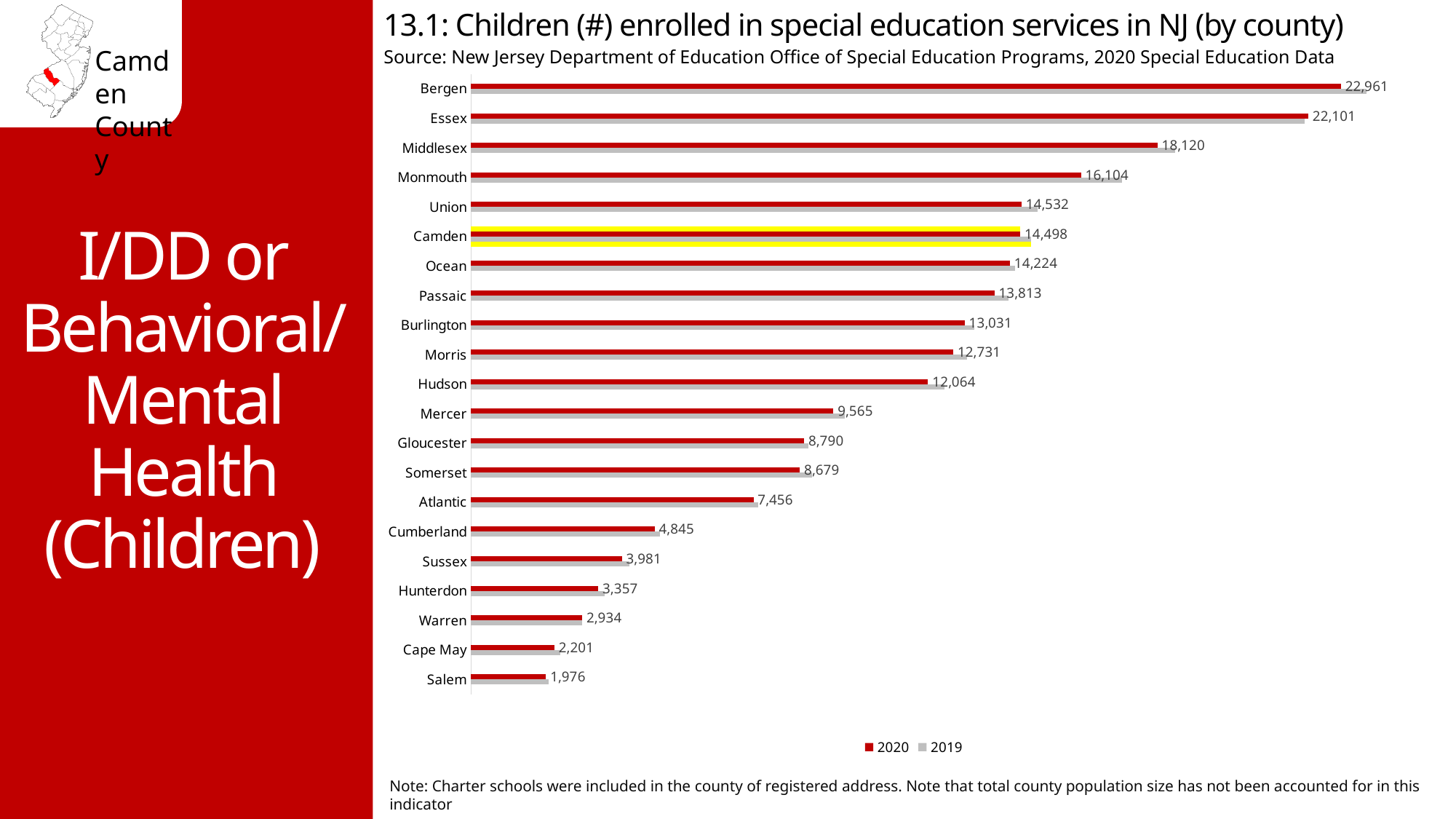
What is the difference between the 2020 values for Camden and Ocean? 274 What is the difference between the 2020 values for Bergen and Essex? 860 Which series is shown in red according to the legend? 2020 What is the 2020 value for Camden in the chart? 14,498 Which county has a larger 2020 value, Mercer or Atlantic? Mercer How many children were enrolled in special education services in Bergen in 2020? 22,961 How many counties are shown in the chart? 21 How many series does the legend list? 2 Which county has the lowest 2020 value in the chart? Salem What is the 2020 value shown for Gloucester? 8,790 What kind of chart is shown on the slide? Bar chart Which county has the highest 2020 value in the chart? Bergen